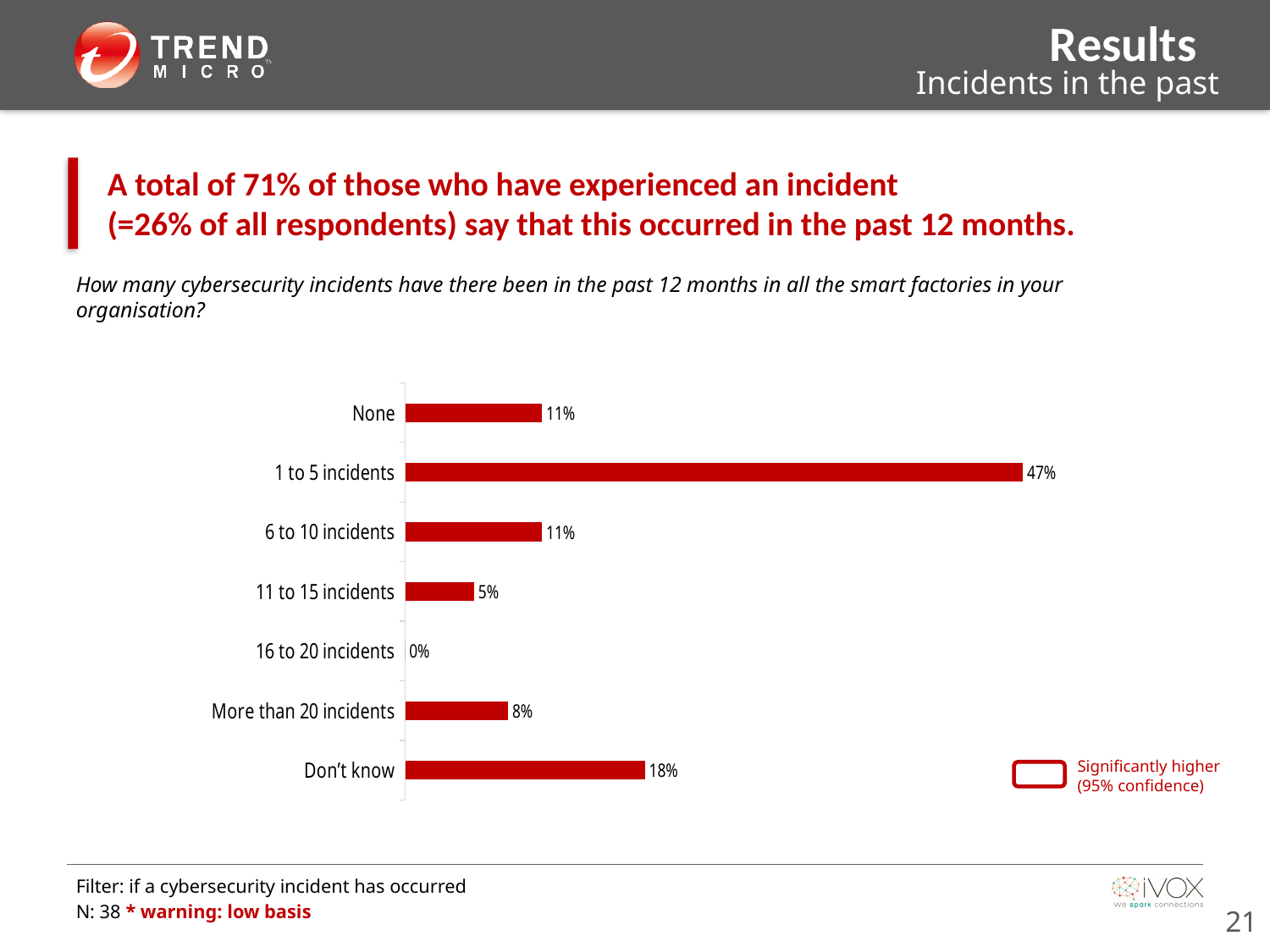
What is the difference in percentage points between '1 to 5 incidents' and 'Don't know'? 29 What is the combined percentage for 'None' and '6 to 10 incidents'? 22% What percentage of respondents reported 11 to 15 incidents? 5% What percentage of respondents reported more than 20 incidents? 8% Which is larger, the value for 'More than 20 incidents' or the value for '11 to 15 incidents'? More than 20 incidents How many categories are shown in the chart? 7 Which category has the highest percentage? 1 to 5 incidents What percentage of respondents answered 'Don't know'? 18% What kind of chart is shown on the slide? Bar chart What percentage of respondents reported 1 to 5 incidents? 47% Which category has the lowest percentage? 16 to 20 incidents What is the sample size (N) stated on the slide? 38